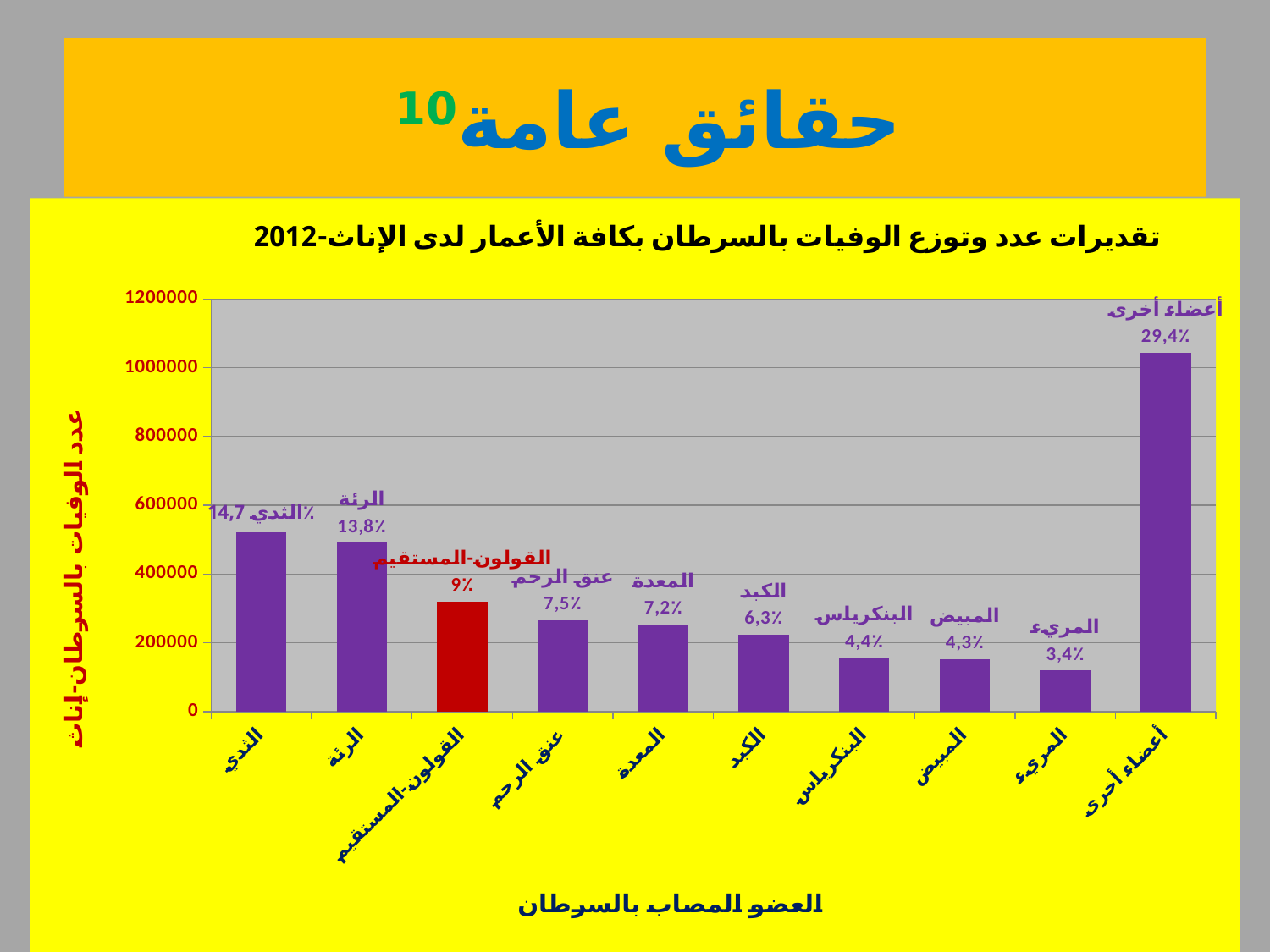
What kind of chart is shown on the slide? bar chart Which category has the shortest bar? المريء What percentage label is shown above the bar for المريء? 3,4% Is the value for الثدي greater or less than 400000? greater Which bar is taller, الثدي or الكبد? الثدي How many categories are shown on the x axis? 10 Is the value for أعضاء أخرى greater or less than 800000? greater Which category has the tallest bar? أعضاء أخرى What percentage label is shown above the bar for أعضاء أخرى? 29,4% Is the value for المريء greater or less than 200000? less What percentage label is shown above the bar for الثدي? 14,7% What percentage label is shown above the bar for الرئة? 13,8%